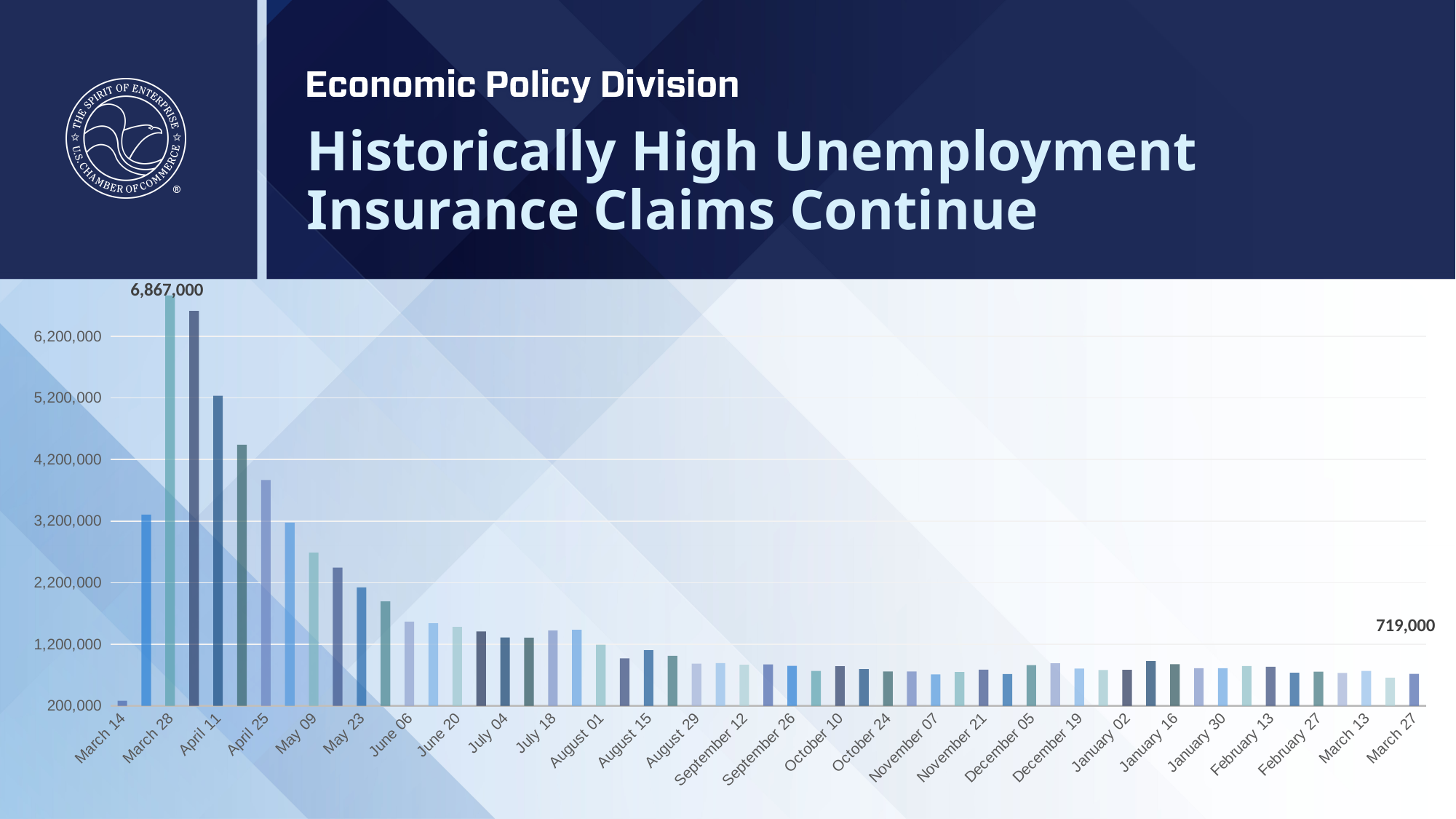
What is the value labeled on the tallest bar (March 28)? 6,867,000 Which date has the highest value in the chart? March 28 What kind of chart is shown on the slide? Bar chart Is the value for April 25 greater or less than 3,200,000? greater What is the title of the slide containing the chart? Historically High Unemployment Insurance Claims Continue What is the difference between the labeled peak value (6,867,000) and the labeled final value (719,000)? 6,148,000 Which date has the lowest value in the chart? March 14 After the peak at March 28, do the values generally rise or fall along the x axis? Fall Is the value for August 29 greater or less than 1,200,000? less Is the value for June 06 greater or less than 1,200,000? greater Which is larger, the value for April 11 or the value for May 09? April 11 What is the value labeled for March 27, the last bar in the chart? 719,000